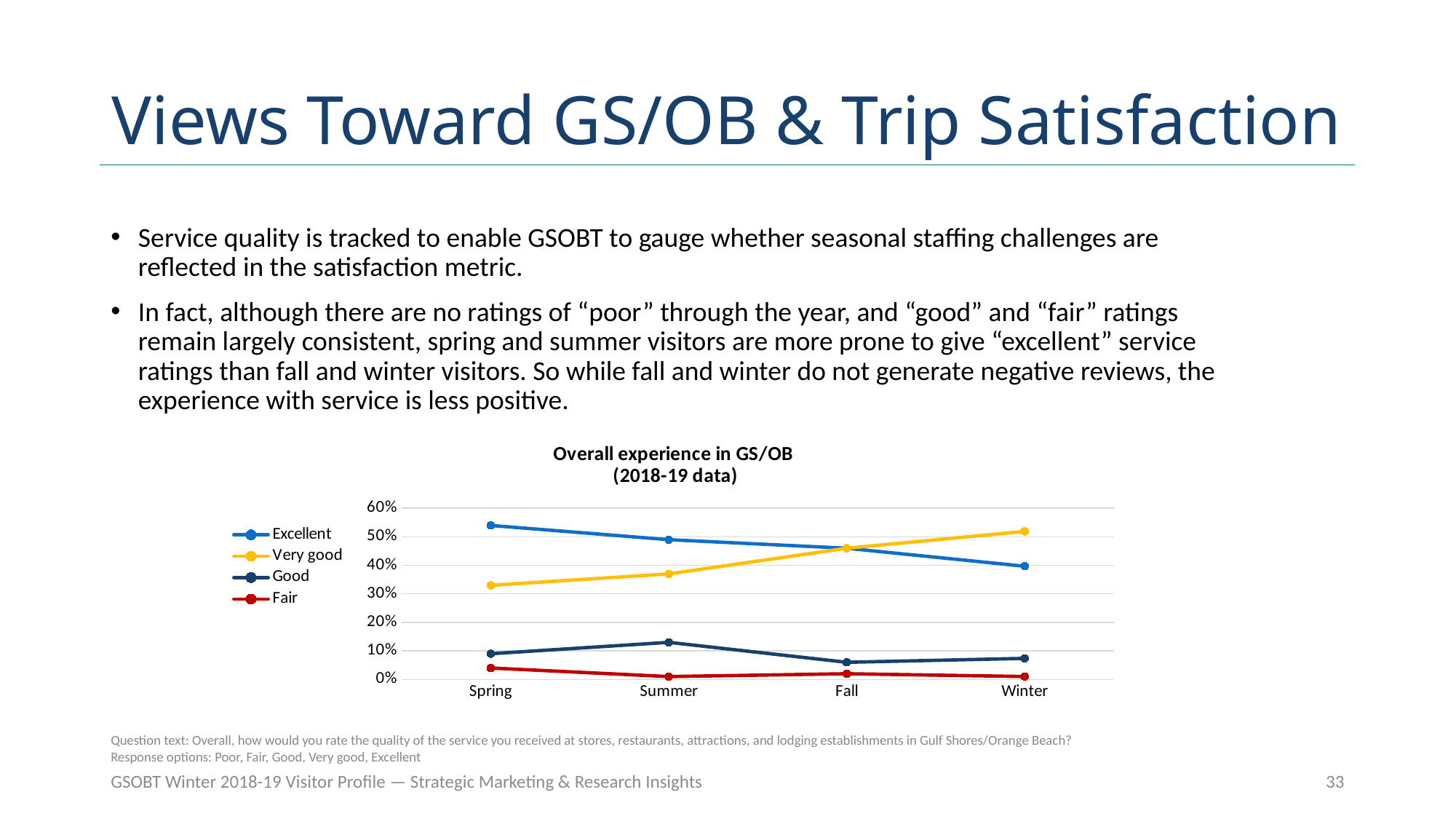
In which season is the Excellent series highest? Spring Does the Very good series rise or fall from Spring to Winter? rise In Winter, which is larger: Excellent or Very good? Very good Is the value for Excellent in Spring greater or less than 50%? greater Is the value for Excellent in Winter greater or less than 50%? less Is the value for Very good in Spring greater or less than 40%? less How many series does the legend list? 4 What is the title of the chart? Overall experience in GS/OB (2018-19 data) In Spring, which is larger: Excellent or Very good? Excellent How many seasons are plotted along the x axis? 4 What kind of chart is shown on the slide? line chart